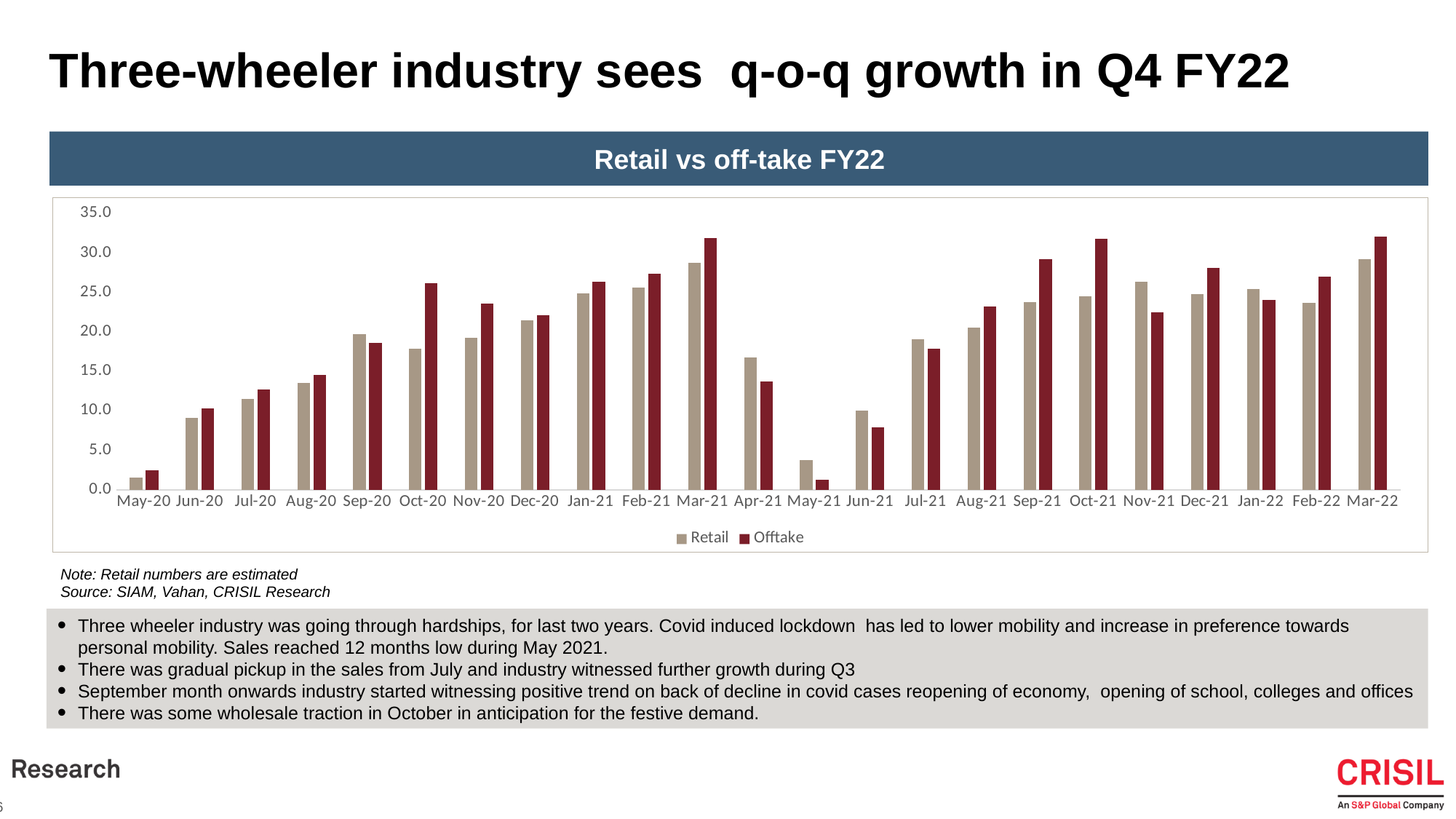
Is the Retail value for May-21 greater or less than 5.0? less Which month has the lowest Offtake value? May-21 How many months are shown on the x axis? 23 What kind of chart is shown on the slide? Bar chart Which is larger in Apr-21, Retail or Offtake? Retail Is the Offtake value for Sep-21 greater or less than 25.0? greater How many series does the legend list? 2 Is the Offtake value for Oct-20 greater or less than 25.0? greater Which month has the lowest Retail value? May-20 What is the title of the chart? Retail vs off-take FY22 Which is larger in Oct-20, Retail or Offtake? Offtake Do the Retail values rise or fall from May-20 to Mar-21? Rise